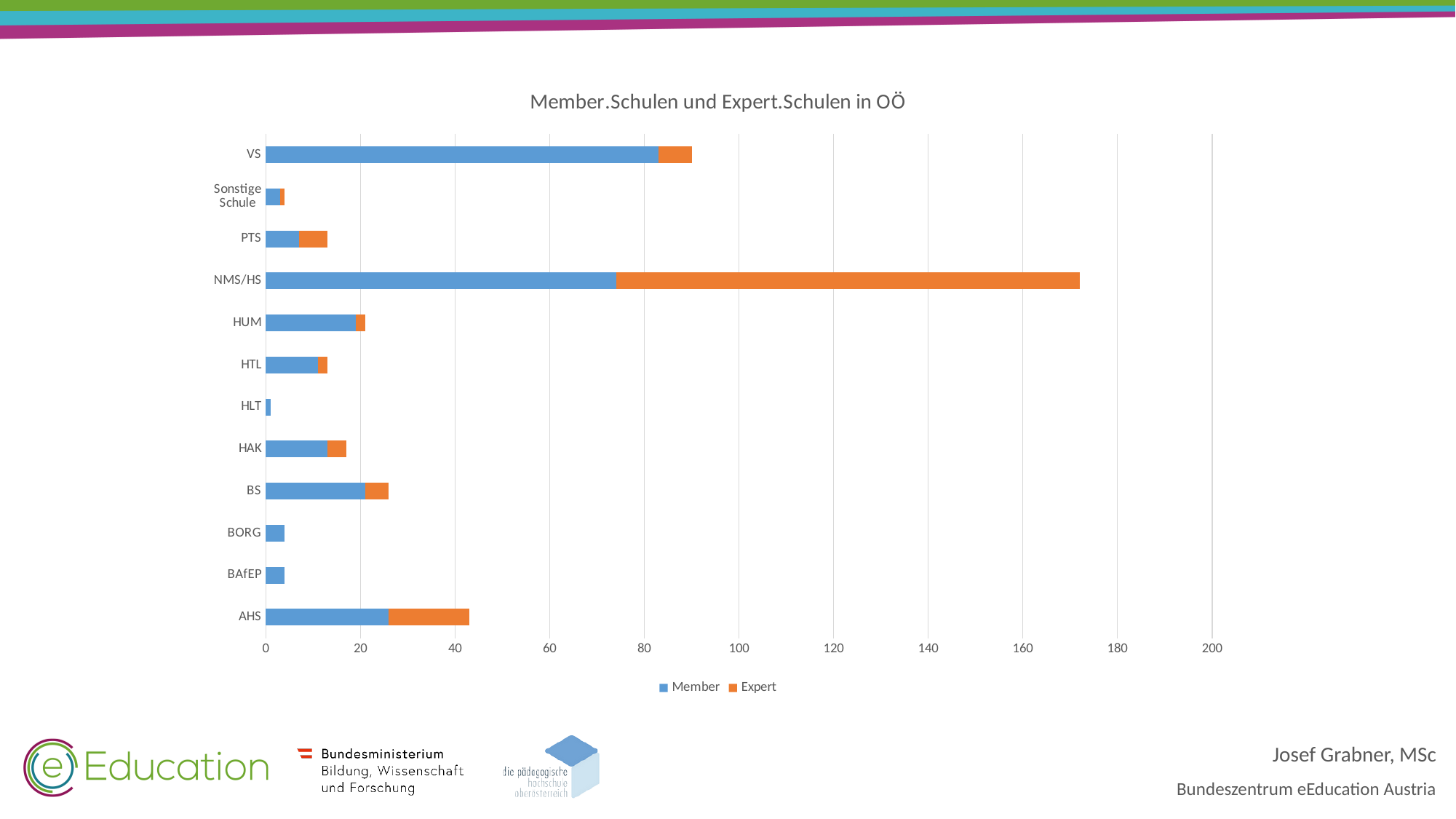
Is the total value for HAK greater or less than 20? less How many school categories are shown on the chart? 12 What is the title of the chart? Member.Schulen und Expert.Schulen in OÖ Which category has the shortest total bar? HLT Is the total value for VS greater or less than 80? greater Which colour represents the Expert series in the legend? Orange What kind of chart is shown on the slide? Stacked bar chart Which category has the longest total bar? NMS/HS Is the total value for NMS/HS greater or less than 180? less Which category has the largest Expert segment? NMS/HS How many series does the legend list? 2 Which is larger, the total bar for VS or the total bar for AHS? VS